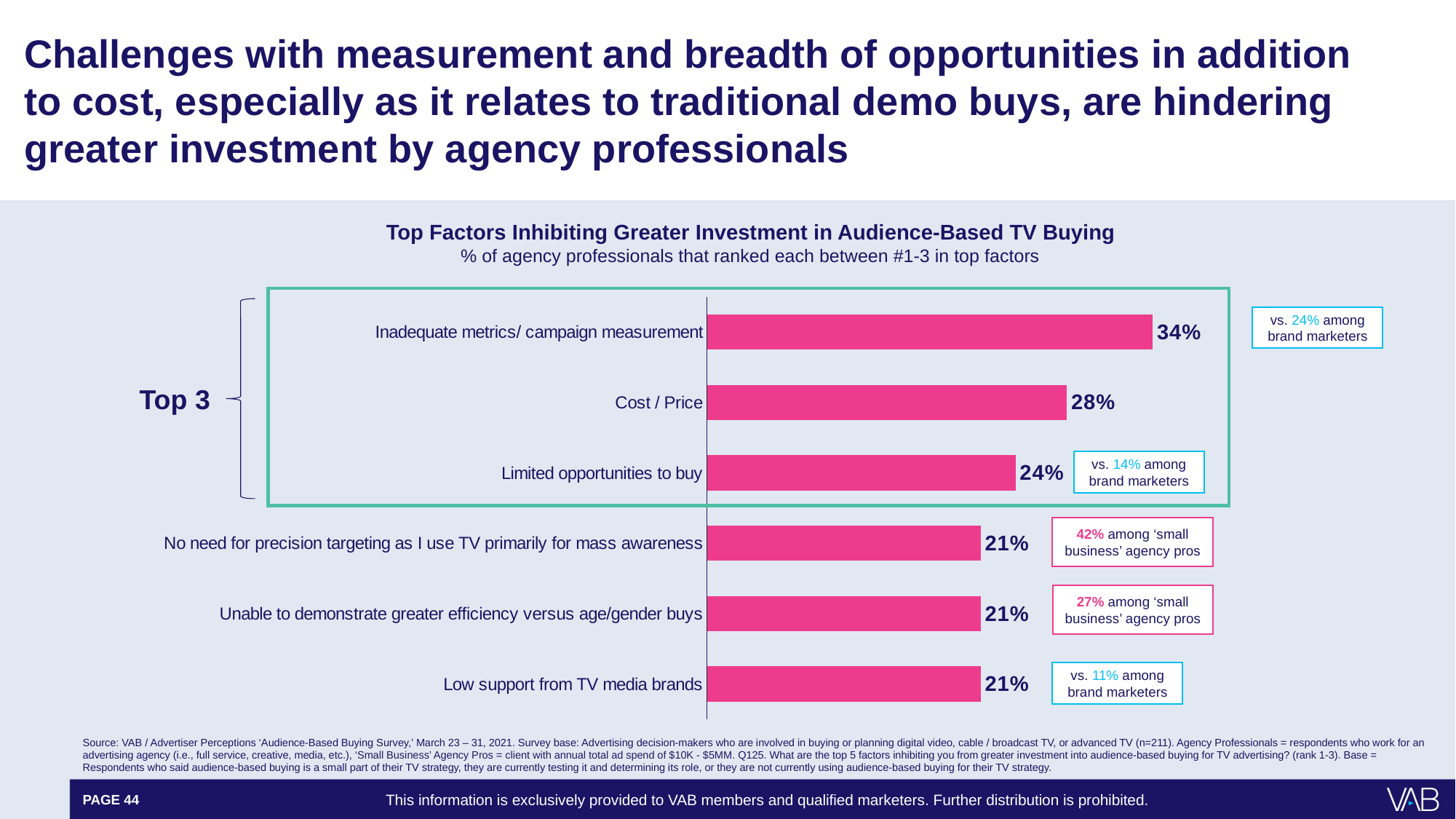
According to the callout, what percentage of brand marketers cited 'Inadequate metrics/ campaign measurement'? 24% What is the difference between 'Cost / Price' and 'Limited opportunities to buy'? 4 percentage points Which is larger: the value for 'Cost / Price' or the value for 'No need for precision targeting as I use TV primarily for mass awareness'? Cost / Price What is the value shown for 'Low support from TV media brands'? 21% What type of chart is shown on the slide? Bar chart What is the title of the chart? Top Factors Inhibiting Greater Investment in Audience-Based TV Buying Which factor has the highest percentage in the chart? Inadequate metrics/ campaign measurement What is the value shown for 'Cost / Price'? 28% How many factors are plotted in the chart? 6 What percentage of agency professionals ranked 'Inadequate metrics/ campaign measurement' among their top factors? 34% What is the value shown for 'Limited opportunities to buy'? 24% What is the difference in percentage points between 'Inadequate metrics/ campaign measurement' and 'Cost / Price'? 6 percentage points